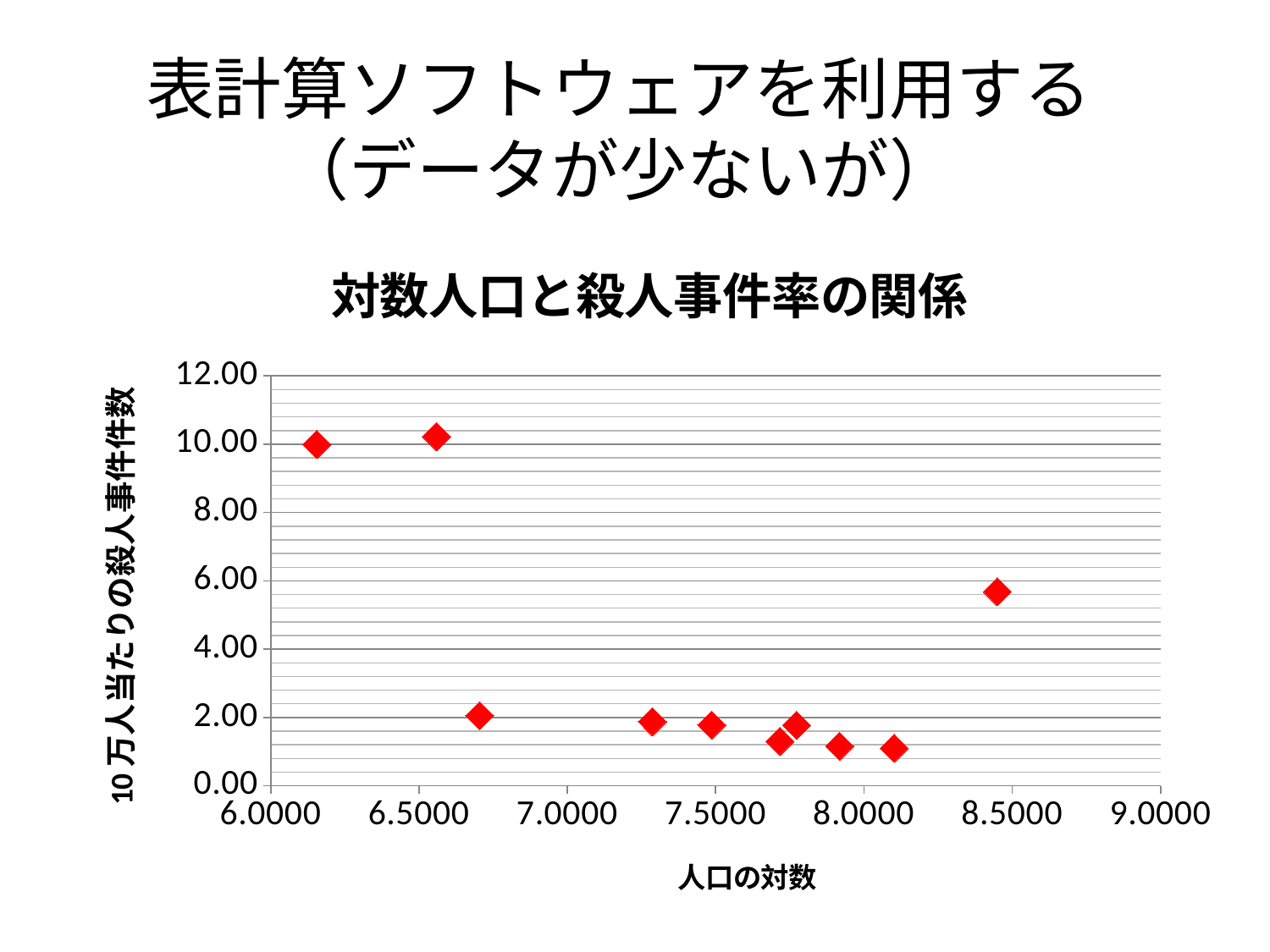
What is the title of the chart? 対数人口と殺人事件率の関係 What is the label of the horizontal axis? 人口の対数 How many data points are plotted in the chart? 10 Is the value for the point near 8.1 on the x axis greater or less than 2.00? less Is the value for the leftmost point (near 6.15 on the x axis) greater or less than 8.00? greater Which is larger: the value for the point near 8.45 on the x axis or the value for the point near 7.9 on the x axis? the point near 8.45 How many points have a value above 8.00 on the vertical axis? 2 What is the highest tick value shown on the vertical axis? 12.00 Is the value for the point at about 8.5 on the x axis greater or less than 4.00? greater What kind of chart is shown on the slide? scatter chart